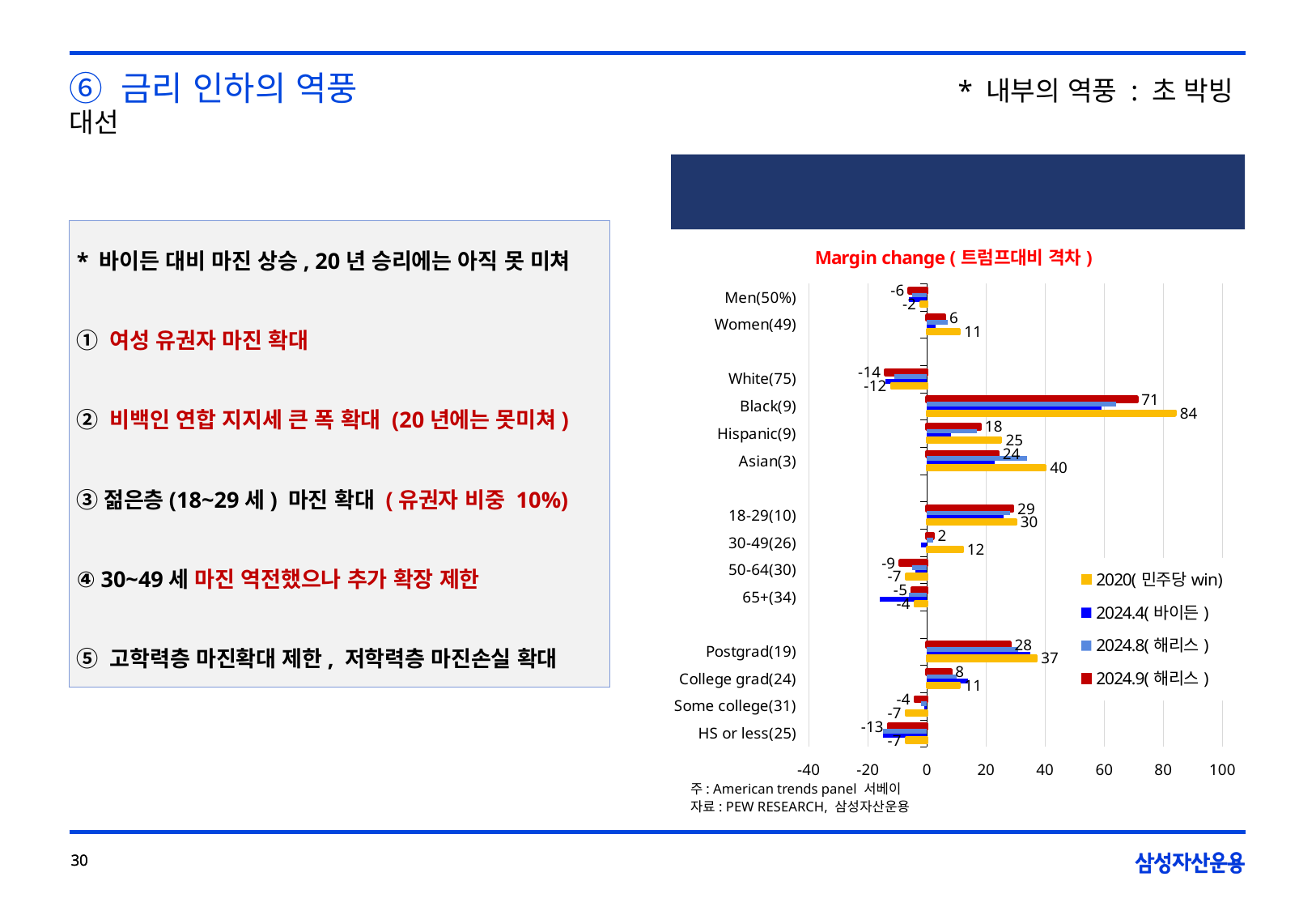
How many categories are plotted on the chart? 14 What is the 2024.9( 해리스 ) value for Black(9)? 71 What is the 2020( 민주당 win) value for Postgrad(19)? 37 Is the 2024.4( 바이든 ) value for Black(9) greater or less than 40? greater For Women(49), which is larger: the 2020( 민주당 win) value or the 2024.9( 해리스 ) value? 2020( 민주당 win) What is the difference between the 2020( 민주당 win) and 2024.9( 해리스 ) values for Black(9)? 13 Which category has the highest 2020( 민주당 win) value? Black(9) What is the 2020( 민주당 win) value for Black(9)? 84 How many series does the legend of the chart list? 4 What kind of chart is shown on the slide? bar chart What is the 2024.9( 해리스 ) value for Asian(3)? 24 What is the title of the chart? Margin change ( 트럼프대비 격차 )